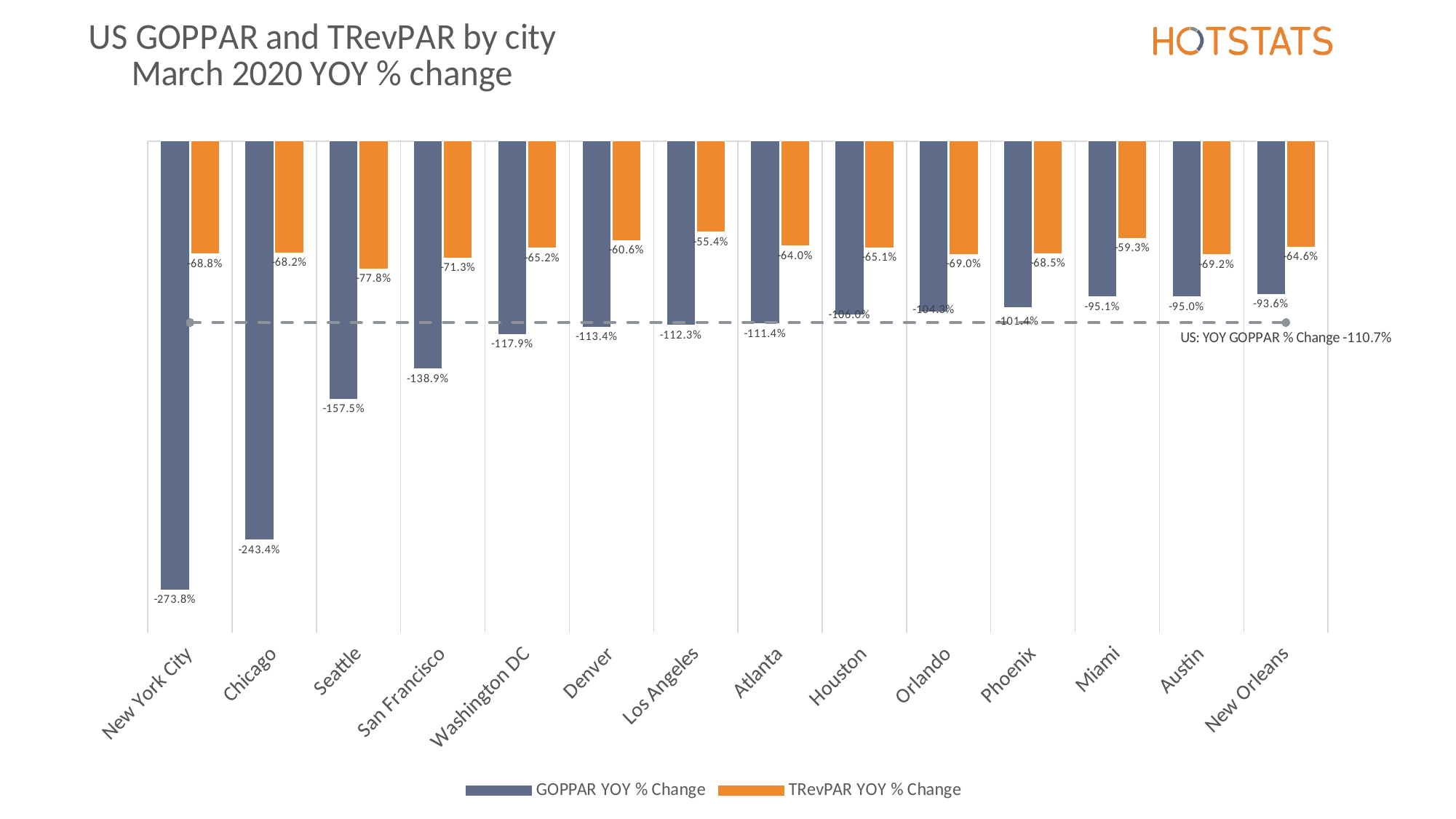
What kind of chart is shown on the slide? Bar chart What is the GOPPAR YOY % change for New York City? -273.8% Which city has the lowest (most negative) TRevPAR YOY % change? Seattle What value does the dashed horizontal line represent? US: YOY GOPPAR % Change -110.7% How many cities are shown on the chart? 14 What is the difference in percentage points between the GOPPAR YOY % change for New York City and Chicago? 30.4 percentage points Which city has the lowest (most negative) GOPPAR YOY % change? New York City What is the TRevPAR YOY % change for Seattle? -77.8% What is the GOPPAR YOY % change for Miami? -95.1% Which city has the highest (least negative) TRevPAR YOY % change? Los Angeles How many series does the legend list? 2 Which city has a more negative GOPPAR YOY % change, Seattle or San Francisco? Seattle